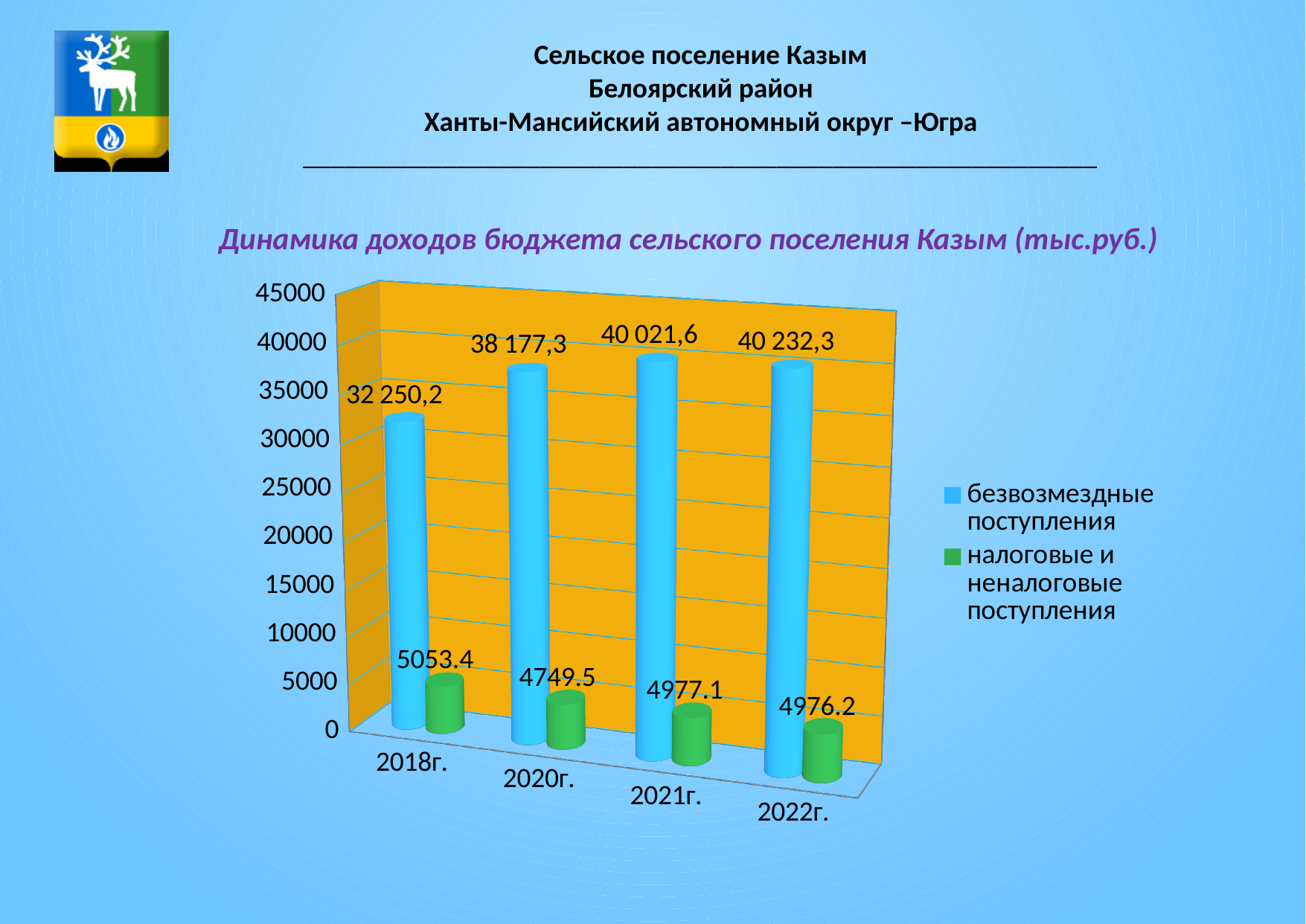
What is the value of безвозмездные поступления for 2018г.? 32 250,2 Do the values of безвозмездные поступления rise or fall from 2018г. to 2022г.? rise In which year is налоговые и неналоговые поступления the highest? 2018г. How many series does the legend list? 2 Which is larger: безвозмездные поступления in 2020г. or in 2021г.? 2021г. What is the value of безвозмездные поступления for 2022г.? 40 232,3 What is the value of налоговые и неналоговые поступления for 2021г.? 4977.1 In which year is безвозмездные поступления the lowest? 2018г. What is the difference between налоговые и неналоговые поступления in 2018г. and 2020г.? 303.9 What is the difference between безвозмездные поступления in 2022г. and 2021г.? 210,7 Is the value of безвозмездные поступления for 2018г. greater or less than 30000? greater How many years are shown on the x axis of the chart? 4